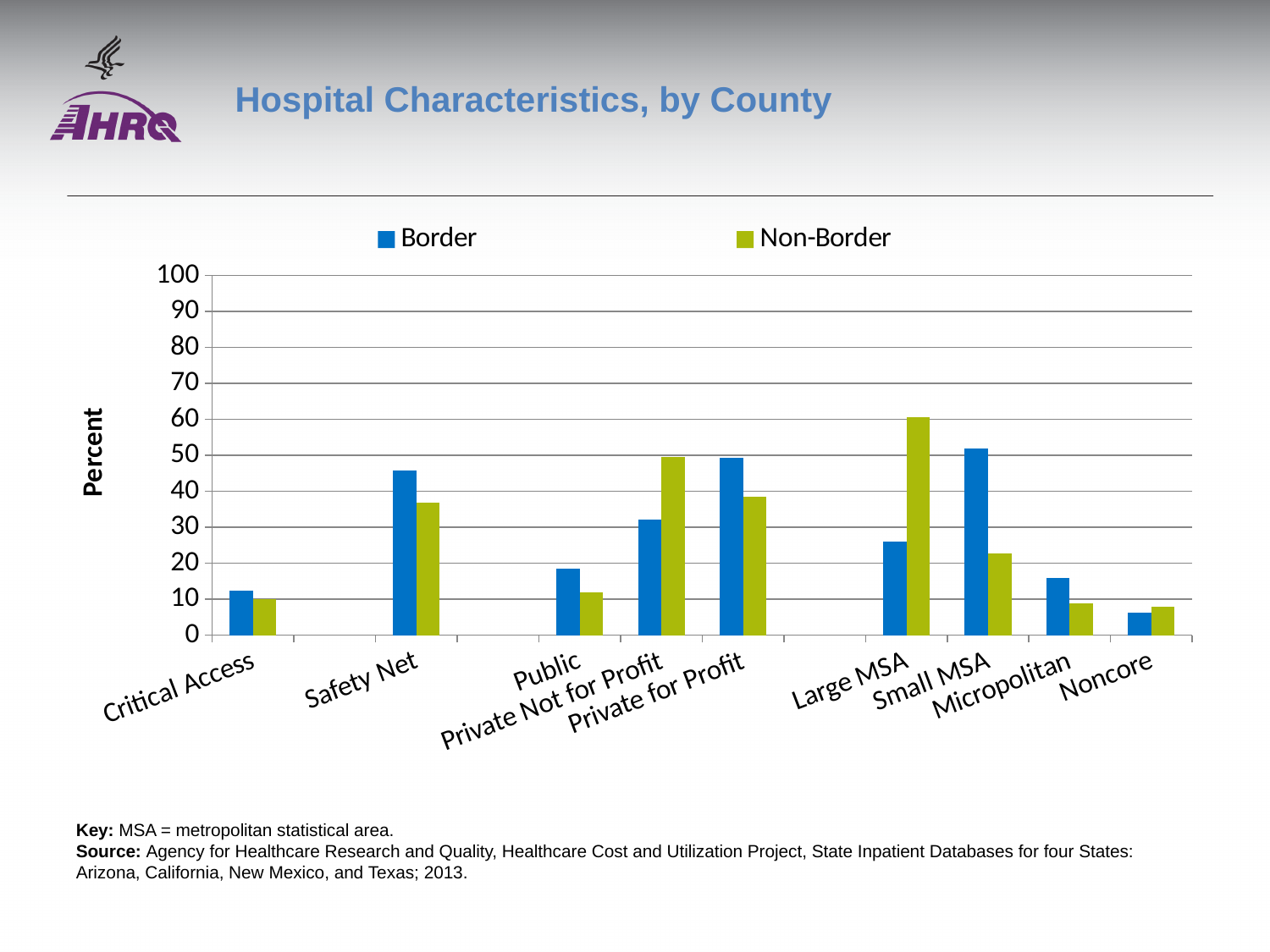
Is the Non-Border value for Small MSA greater or less than 30? less For Safety Net, which is larger: the Border or the Non-Border value? Border What kind of chart is shown on the slide? bar chart Is the Border value for Safety Net greater or less than 40? greater What is the label on the y axis? Percent Is the Non-Border value for Large MSA greater or less than 50? greater Which category has the lowest Border value? Noncore How many hospital characteristic categories are shown on the x axis? 9 For Private Not for Profit, which is larger: the Border or the Non-Border value? Non-Border How many series does the legend list? 2 Which category has the highest Non-Border value? Large MSA